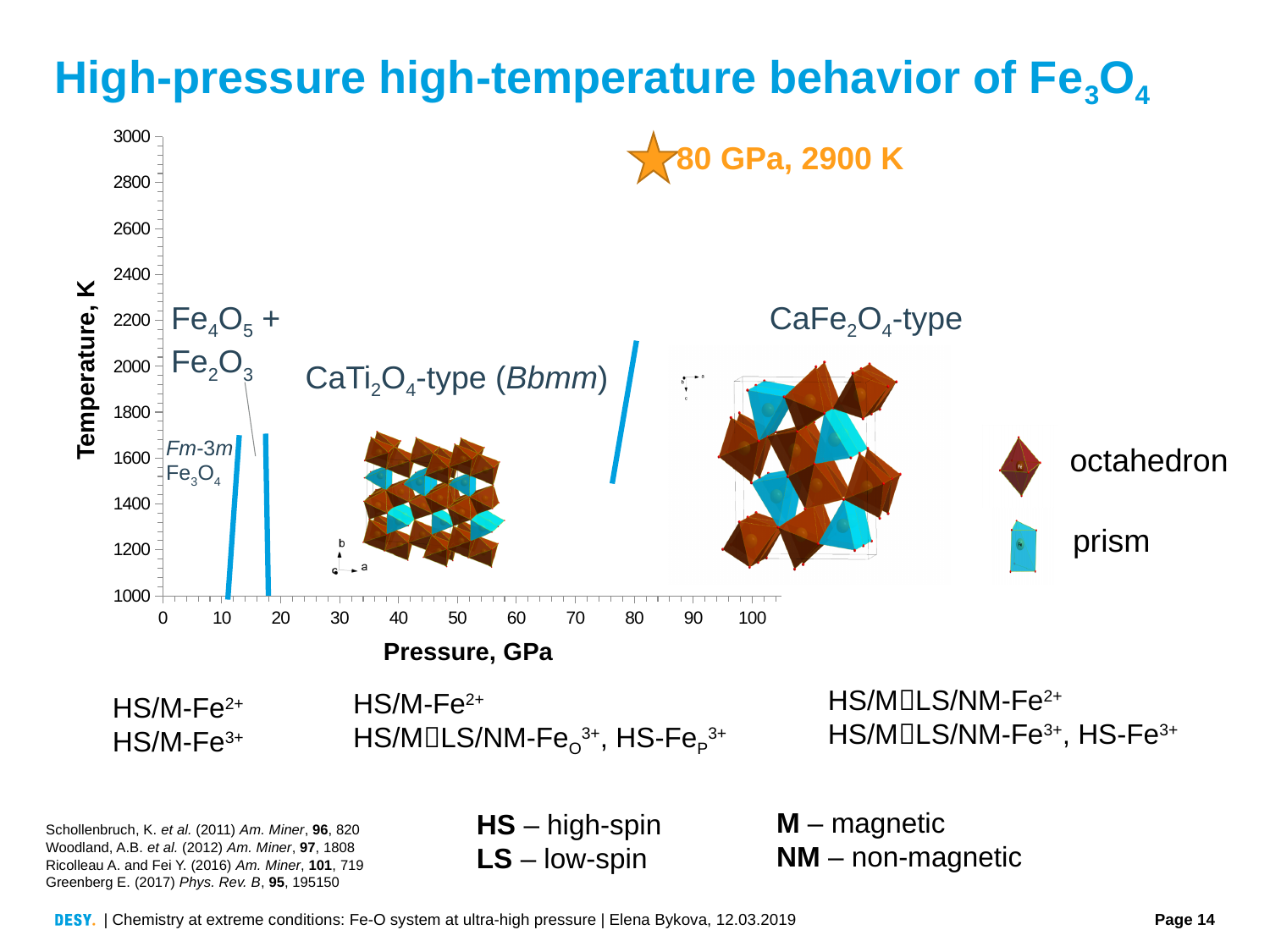
Is the pressure of the star marker greater or less than 70 GPa? greater What is the label of the y axis of the phase diagram? Temperature, K What is the highest temperature value shown on the y axis? 3000 How many phase regions are labeled on the diagram? 4 What pressure and temperature does the star marker on the phase diagram indicate? 80 GPa, 2900 K What is the highest pressure value shown on the x axis? 100 According to the key beside the diagram, what does the cyan polyhedron represent? prism Which phase is labeled in the highest-pressure region of the diagram? CaFe2O4-type Which phase is labeled in the lowest-pressure region of the diagram? Fm-3m Fe3O4 What is the label of the x axis of the phase diagram? Pressure, GPa Is the temperature of the star marker greater or less than 2800 K? greater What space group is given in parentheses for the CaTi2O4-type phase? Bbmm